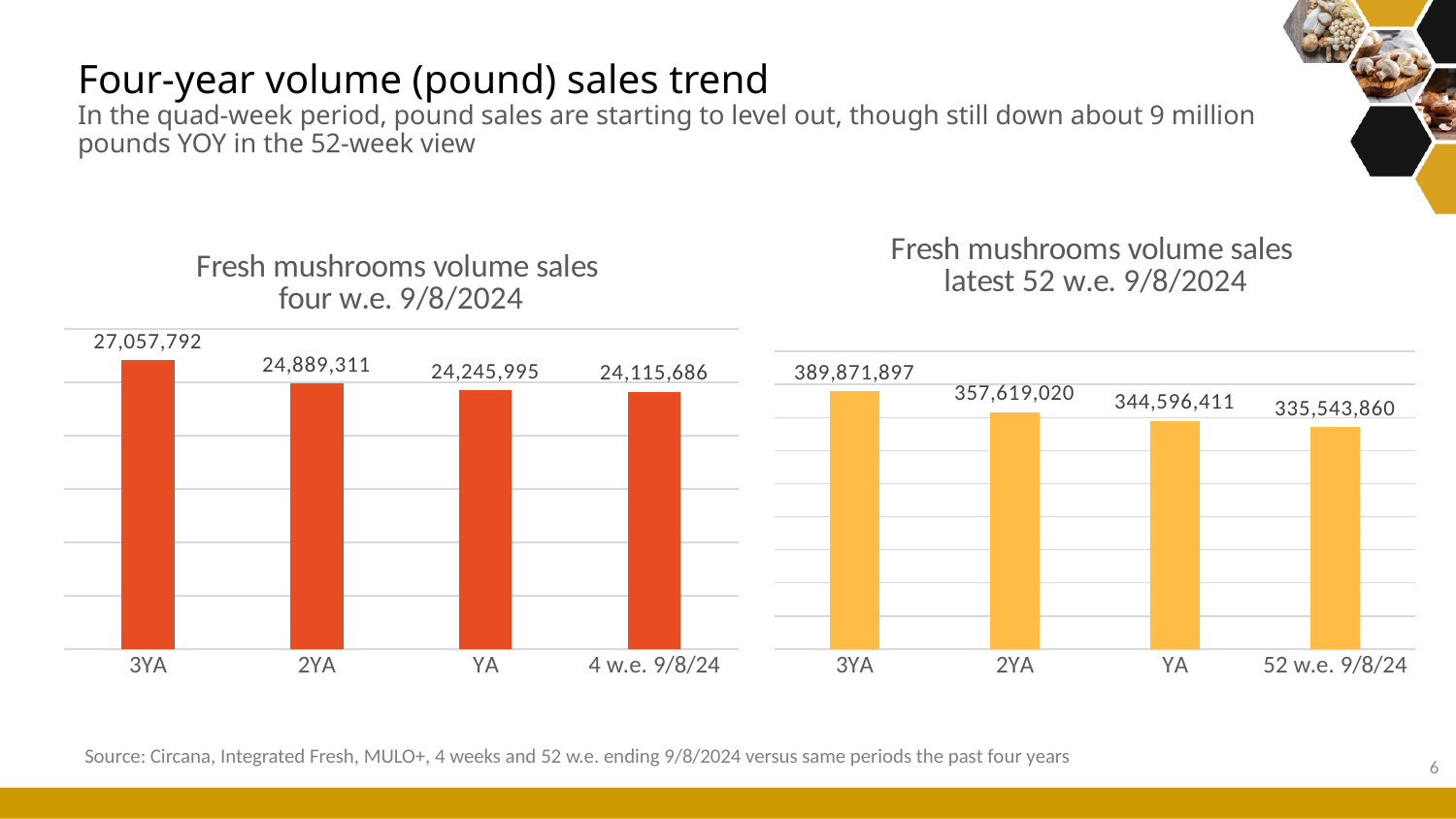
In the 'Fresh mushrooms volume sales latest 52 w.e. 9/8/2024' chart, which is larger, the value for 3YA or the value for YA? 3YA In the 'Fresh mushrooms volume sales four w.e. 9/8/2024' chart, which period has the highest value? 3YA In the 'Fresh mushrooms volume sales latest 52 w.e. 9/8/2024' chart, do the values rise or fall from 3YA to 52 w.e. 9/8/24? Fall In the 'Fresh mushrooms volume sales latest 52 w.e. 9/8/2024' chart, what is the difference between the YA and 52 w.e. 9/8/24 values? 9,052,551 In the 'Fresh mushrooms volume sales latest 52 w.e. 9/8/2024' chart, which period has the lowest value? 52 w.e. 9/8/24 In the 'Fresh mushrooms volume sales four w.e. 9/8/2024' chart, what is the value for 3YA? 27,057,792 In the 'Fresh mushrooms volume sales latest 52 w.e. 9/8/2024' chart, what is the value for 52 w.e. 9/8/24? 335,543,860 In the 'Fresh mushrooms volume sales four w.e. 9/8/2024' chart, what is the difference between the 3YA and 2YA values? 2,168,481 What kind of chart is the 'Fresh mushrooms volume sales latest 52 w.e. 9/8/2024' chart? Bar chart How many bars are in the 'Fresh mushrooms volume sales four w.e. 9/8/2024' chart? 4 In the 'Fresh mushrooms volume sales latest 52 w.e. 9/8/2024' chart, what is the value for 2YA? 357,619,020 In the 'Fresh mushrooms volume sales four w.e. 9/8/2024' chart, what is the value for 4 w.e. 9/8/24? 24,115,686